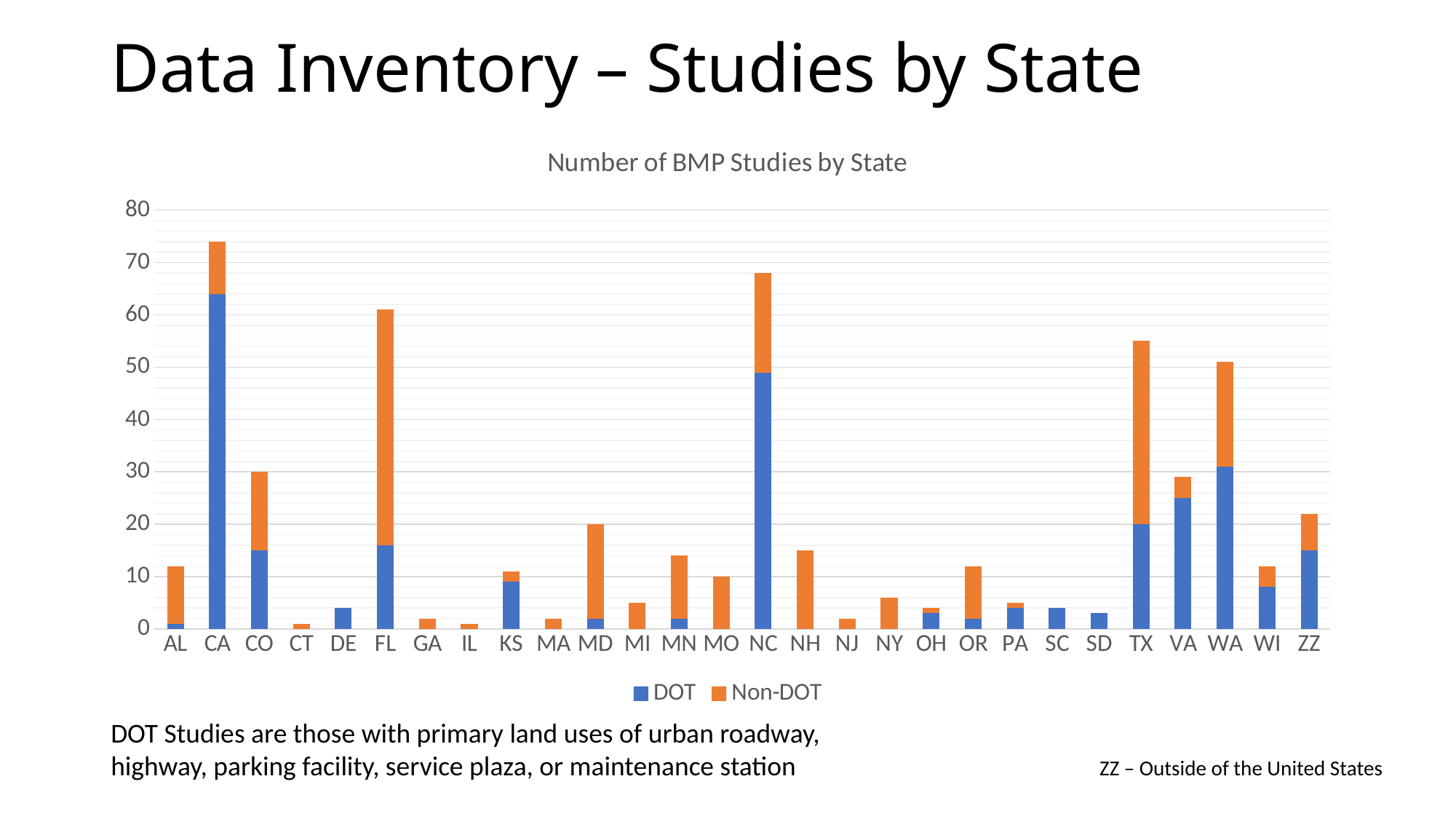
What is the title of the chart? Number of BMP Studies by State How many states (categories) are shown on the x axis? 28 What kind of chart is shown on the slide? Stacked bar chart Which has a larger total number of studies, FL or TX? FL Is the total number of studies for WA greater or less than 40? greater Which state has the largest DOT (blue) segment? CA Which state has the largest Non-DOT (orange) segment? FL Is the total number of studies for TX greater or less than 50? greater How many series does the legend list? 2 Is the total number of studies for CA greater or less than 70? greater Which state has the highest total number of BMP studies? CA